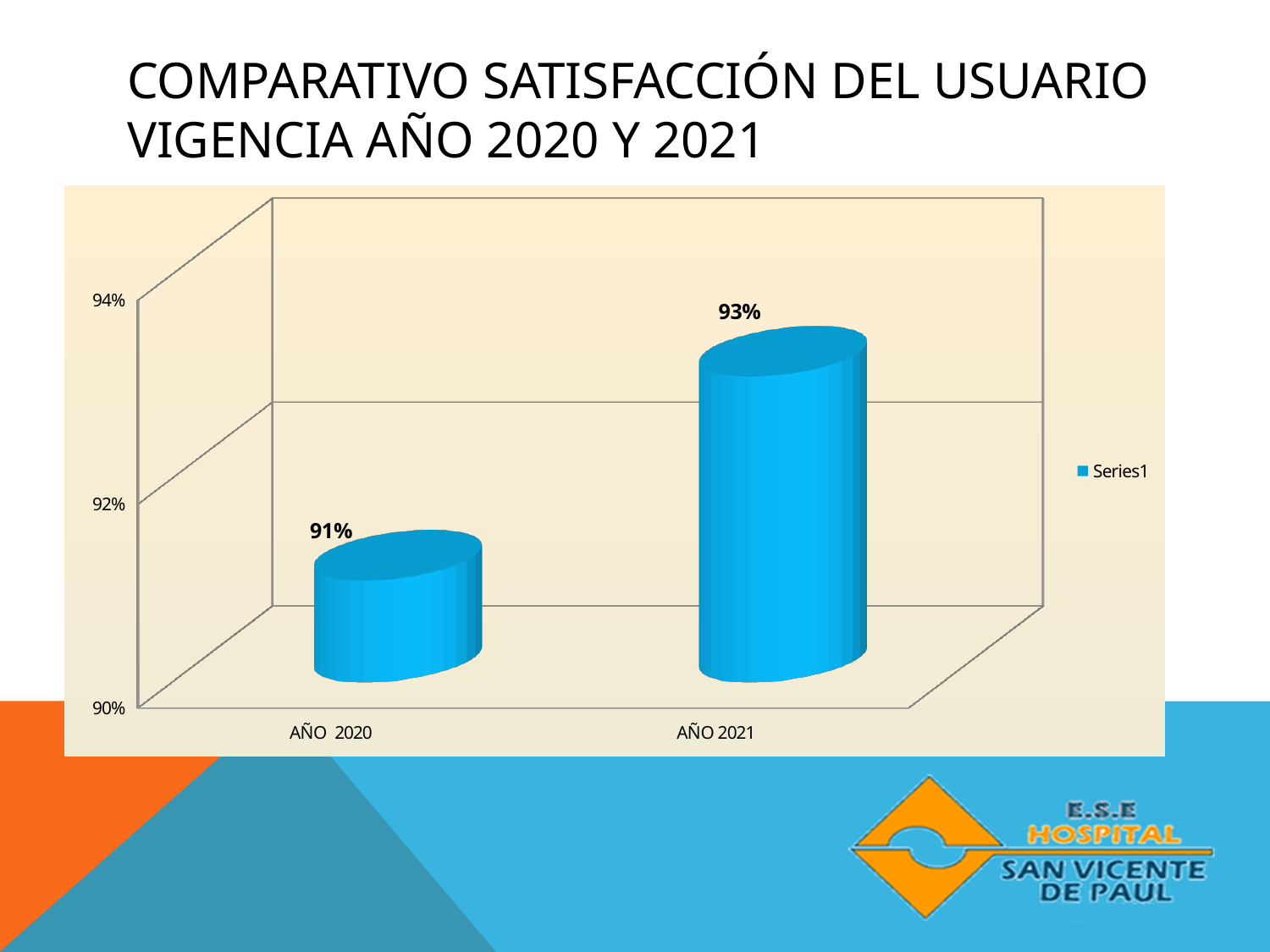
What is the difference between the values for AÑO 2021 and AÑO 2020? 2% What kind of chart is shown on the slide? Bar chart Do the values rise or fall from AÑO 2020 to AÑO 2021? Rise What is the value for AÑO 2021? 93% Which year has the lowest satisfaction value? AÑO 2020 How many categories are shown on the x axis? 2 Is the value for AÑO 2021 greater or less than 92%? greater Which year has the highest satisfaction value? AÑO 2021 What is the value for AÑO 2020? 91% Which is larger, the value for AÑO 2020 or AÑO 2021? AÑO 2021 Is the value for AÑO 2020 greater or less than 92%? less How many series does the legend list? 1